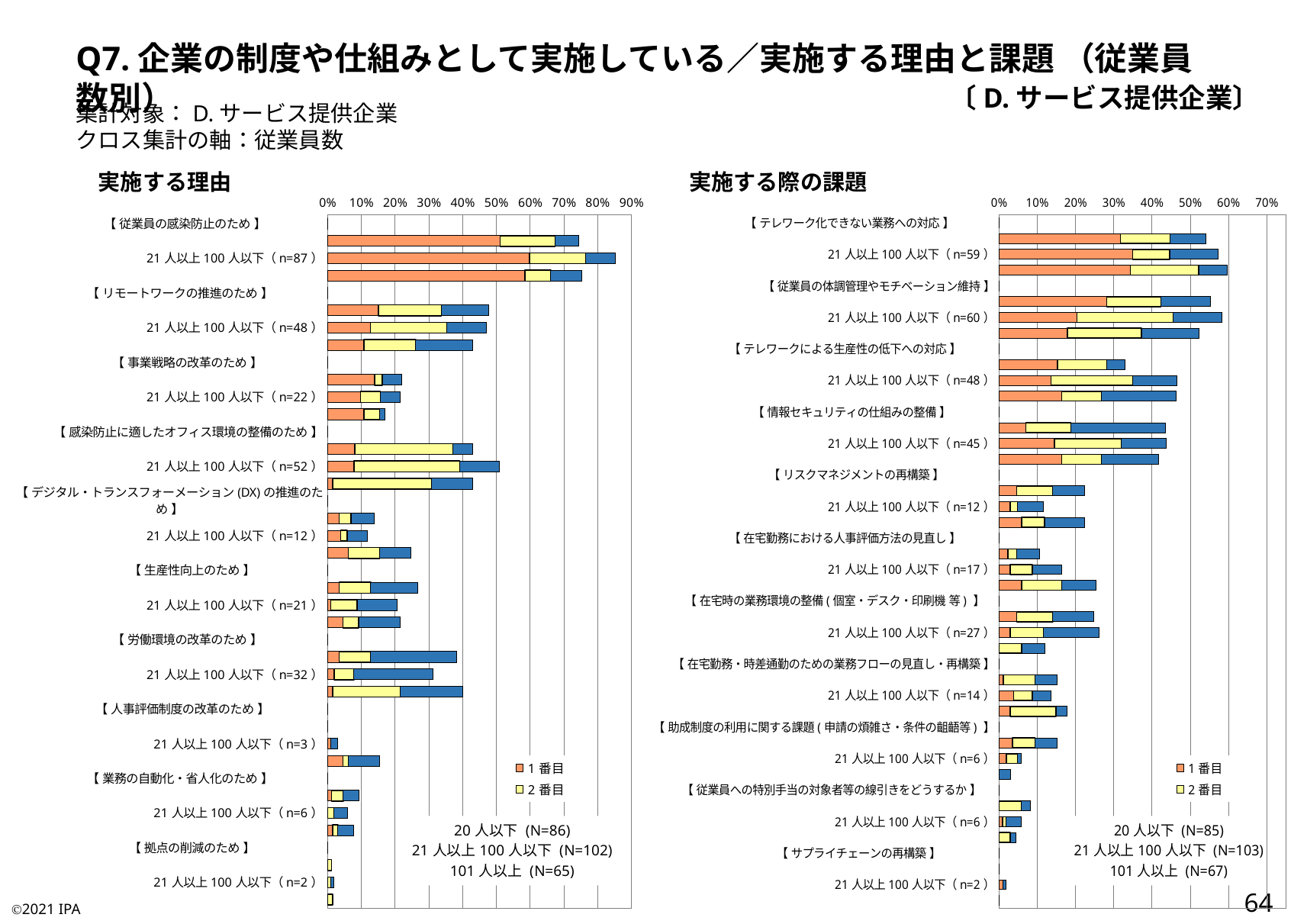
In the right chart (実施する際の課題), is the total bar for 21人以上100人以下 (n=60) under 従業員の体調管理やモチベーション維持 greater or less than 50%? greater How many issue categories are listed in the right chart (実施する際の課題)? 11 In the left chart (実施する理由), which reason has the shortest bars? 拠点の削減のため In the left chart (実施する理由), is the total bar for 21人以上100人以下 (n=48) under リモートワークの推進のため greater or less than 50%? less What kind of chart is the left chart titled 実施する理由? bar chart In the right chart (実施する際の課題), which issue has the shortest bars? サプライチェーンの再構築 In the right chart (実施する際の課題), which has the longer total bar for 21人以上100人以下: テレワーク化できない業務への対応 (n=59) or リスクマネジメントの再構築 (n=12)? テレワーク化できない業務への対応 How many reason categories are listed in the left chart (実施する理由)? 10 In the left chart (実施する理由), which reason has the longest bars? 従業員の感染防止のため In the left chart (実施する理由), which has the longer total bar for 21人以上100人以下: 従業員の感染防止のため (n=87) or 事業戦略の改革のため (n=22)? 従業員の感染防止のため In the left chart (実施する理由), is the total bar for 21人以上100人以下 (n=87) under 従業員の感染防止のため greater or less than 80%? greater In the right chart (実施する際の課題), what is the N for 101人以上 shown in the note? N=67